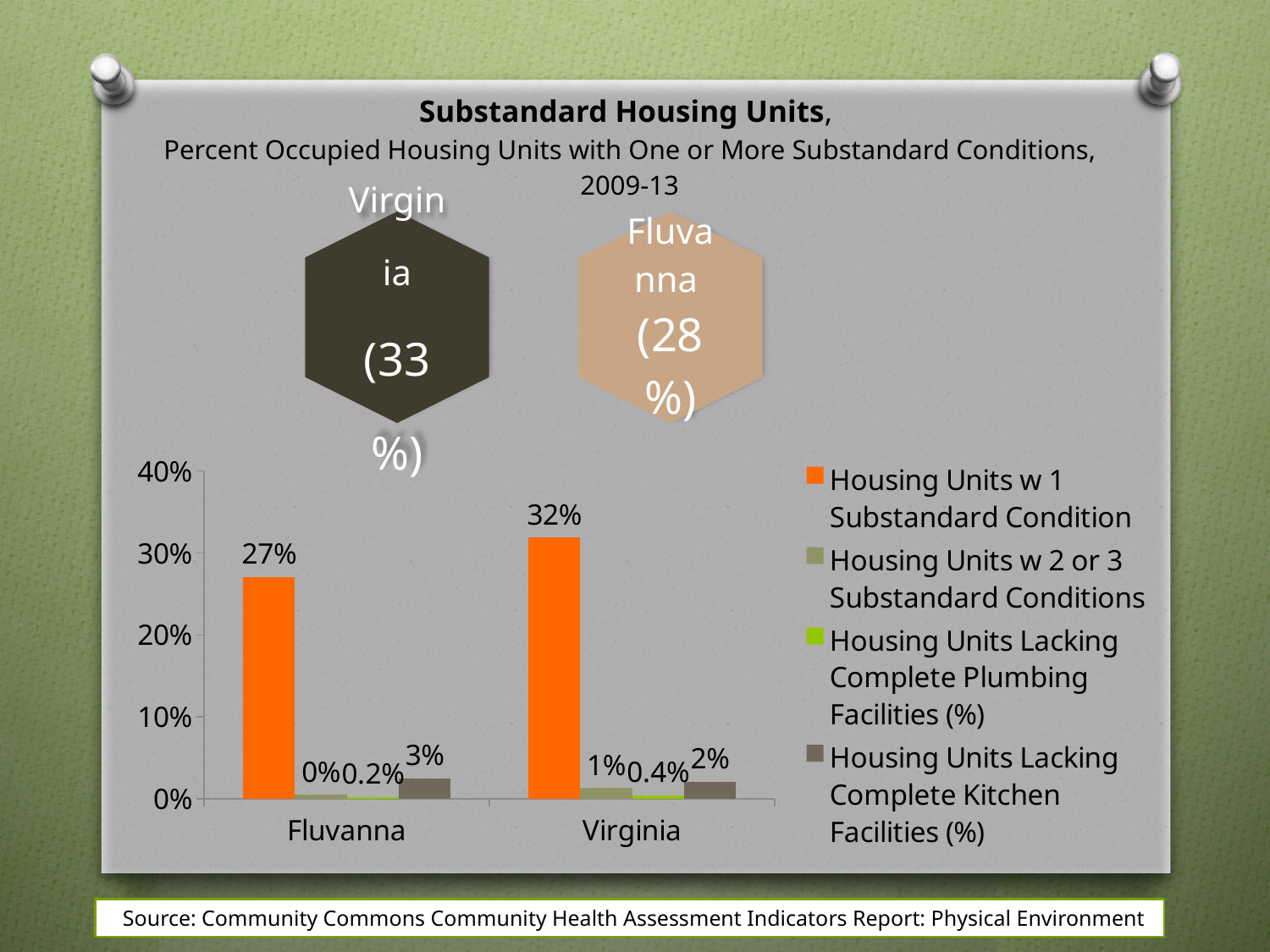
What is the value for Housing Units w 1 Substandard Condition in Virginia? 32% What is the value for Housing Units w 2 or 3 Substandard Conditions in Virginia? 1% What is the value for Housing Units Lacking Complete Plumbing Facilities (%) in Virginia? 0.4% Is the value for Housing Units w 1 Substandard Condition in Virginia greater or less than 30%? greater What is the value for Housing Units Lacking Complete Kitchen Facilities (%) in Fluvanna? 3% Which series is shown in orange in the chart legend? Housing Units w 1 Substandard Condition Which category has the higher value for Housing Units w 1 Substandard Condition, Fluvanna or Virginia? Virginia How many categories are shown on the x axis of the chart? 2 What is the difference between the Housing Units w 1 Substandard Condition values for Virginia and Fluvanna? 5% What kind of chart is shown on the slide? Bar chart How many series does the chart legend list? 4 What is the value for Housing Units w 1 Substandard Condition in Fluvanna? 27%